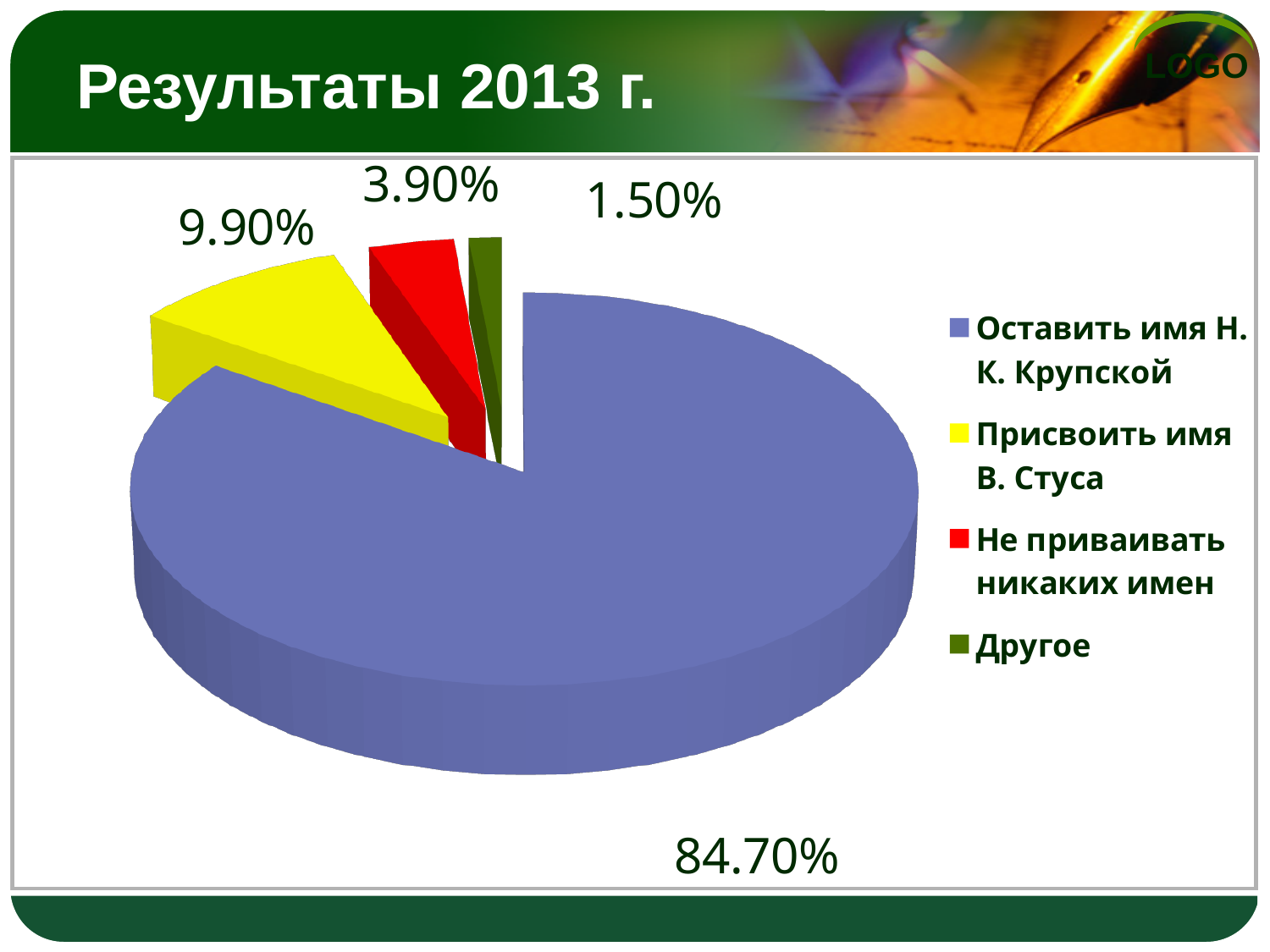
What is the difference between the shares of "Присвоить имя В. Стуса" and "Не приваивать никаких имен"? 6.00% What kind of chart is shown on the slide? Pie chart What share of the pie does "Не приваивать никаких имен" have? 3.90% What share of the pie does "Присвоить имя В. Стуса" have? 9.90% Which category has the largest slice of the pie? Оставить имя Н. К. Крупской How many categories does the pie chart have? 4 Which is larger: the share for "Не приваивать никаких имен" or the share for "Другое"? Не приваивать никаких имен What share of the pie does "Оставить имя Н. К. Крупской" have? 84.70% What is the title of the slide containing the chart? Результаты 2013 г. What share of the pie does "Другое" have? 1.50% Which category has the smallest slice of the pie? Другое What colour is the slice for "Присвоить имя В. Стуса"? Yellow